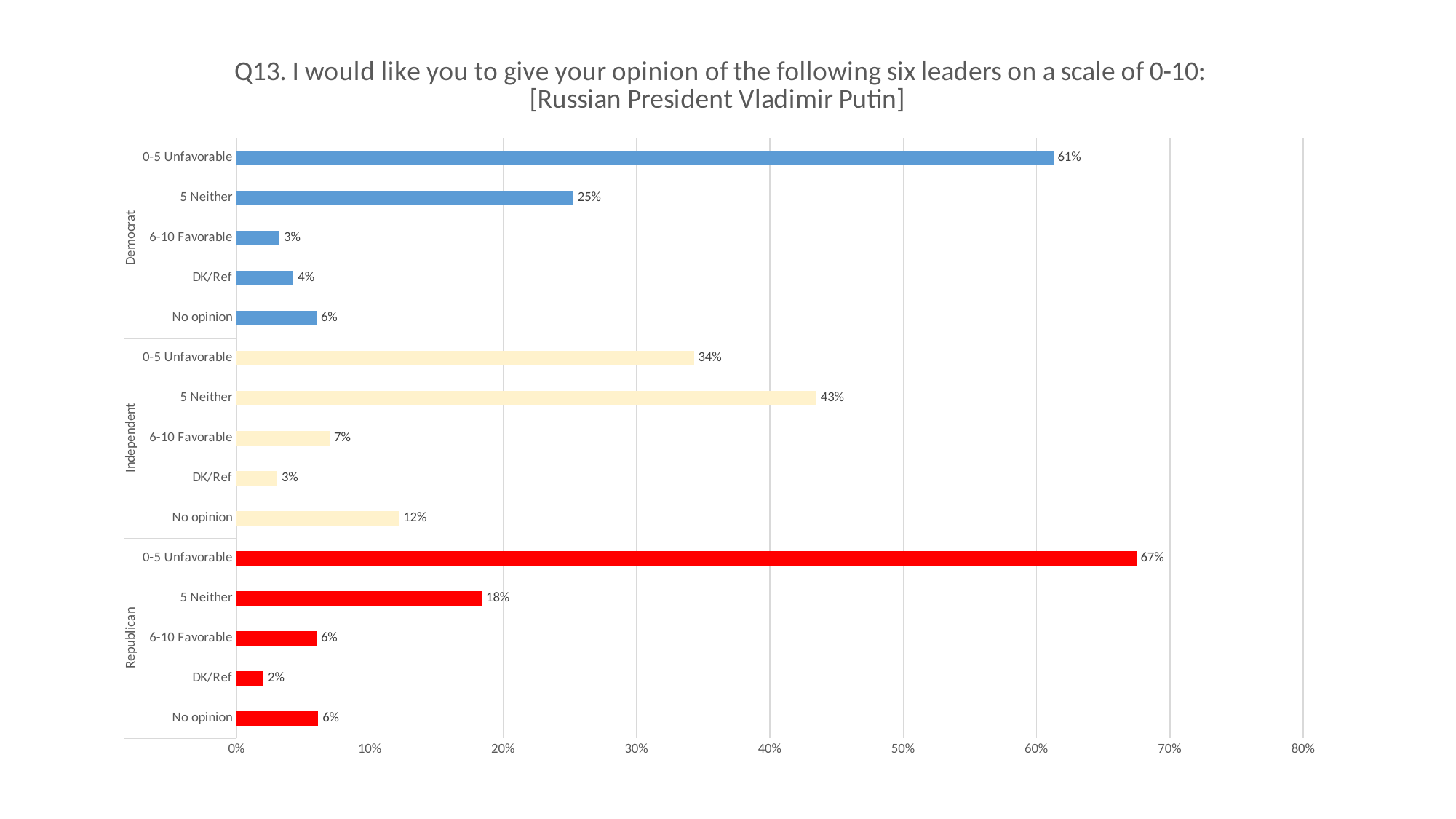
Which is larger: the Independent 5 Neither percentage or the Independent 0-5 Unfavorable percentage? 5 Neither What percentage of Independents answered 5 Neither? 43% Is the Democrat 5 Neither value greater or less than 20%? greater Which response category has the lowest percentage among Democrats? 6-10 Favorable What type of chart is shown on the slide? Bar chart What colour are the bars for the Republican group? Red What percentage of Republicans answered DK/Ref? 2% Which party group has the highest 0-5 Unfavorable percentage? Republican What percentage of Democrats gave a 0-5 Unfavorable rating? 61% How many bars are plotted in the chart? 15 What is the difference between the Independent and Republican No opinion percentages? 6% What is the difference between the Republican and Democrat 0-5 Unfavorable percentages? 6%